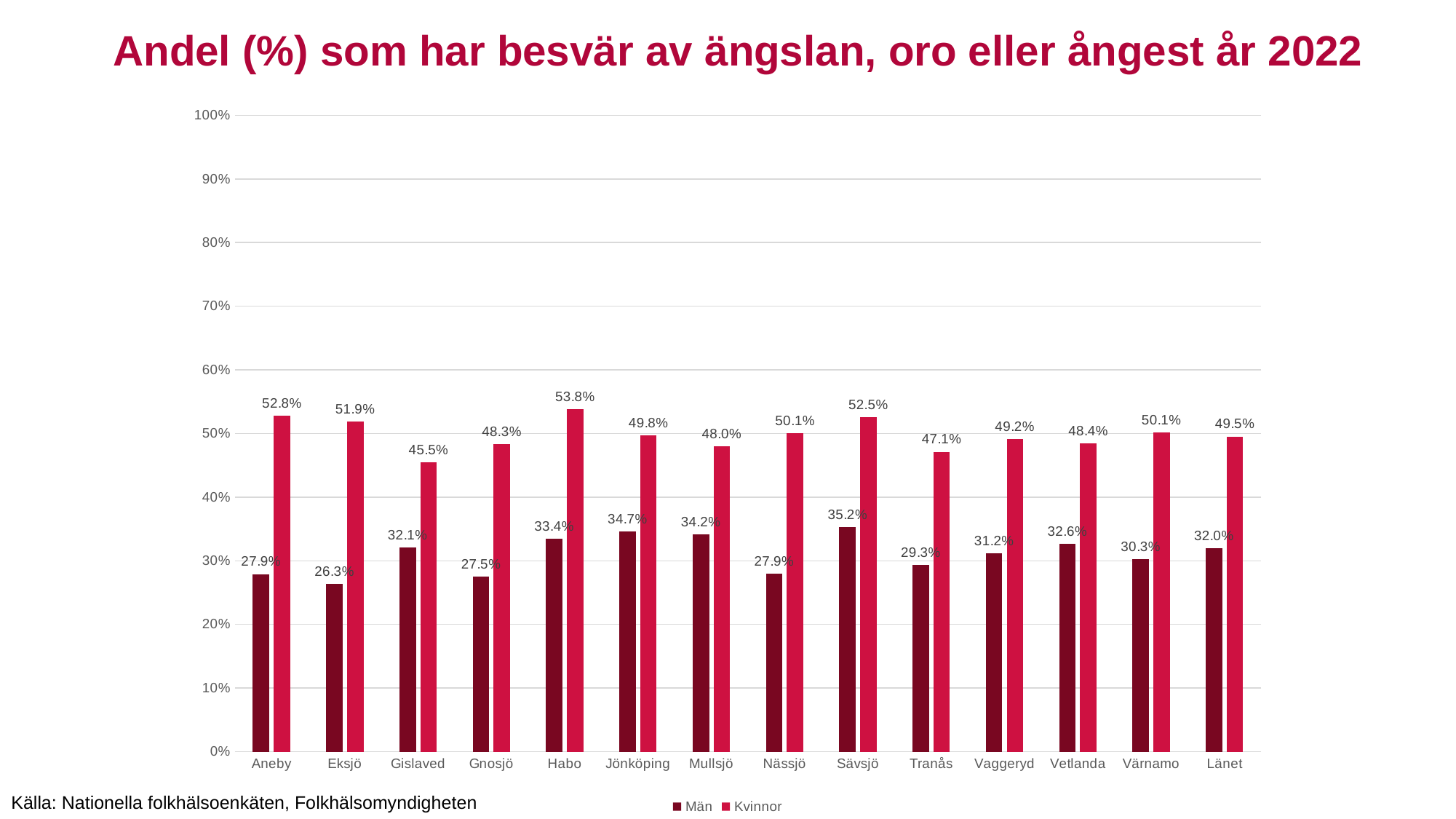
What kind of chart is shown on the slide? Bar chart Which is larger, the Män value for Sävsjö or the Män value for Tranås? Sävsjö How many categories are shown on the x axis? 14 What is the value for Kvinnor in Länet? 49.5% Which category has the highest value for Kvinnor? Habo Which category has the lowest value for Kvinnor? Gislaved What is the value for Kvinnor in Habo? 53.8% What is the value for Män in Jönköping? 34.7% How many series does the legend list? 2 What is the difference between the Kvinnor and Män values in Aneby? 24.9% Is the value for Kvinnor in Gnosjö greater or less than 50%? less Which category has the lowest value for Män? Eksjö